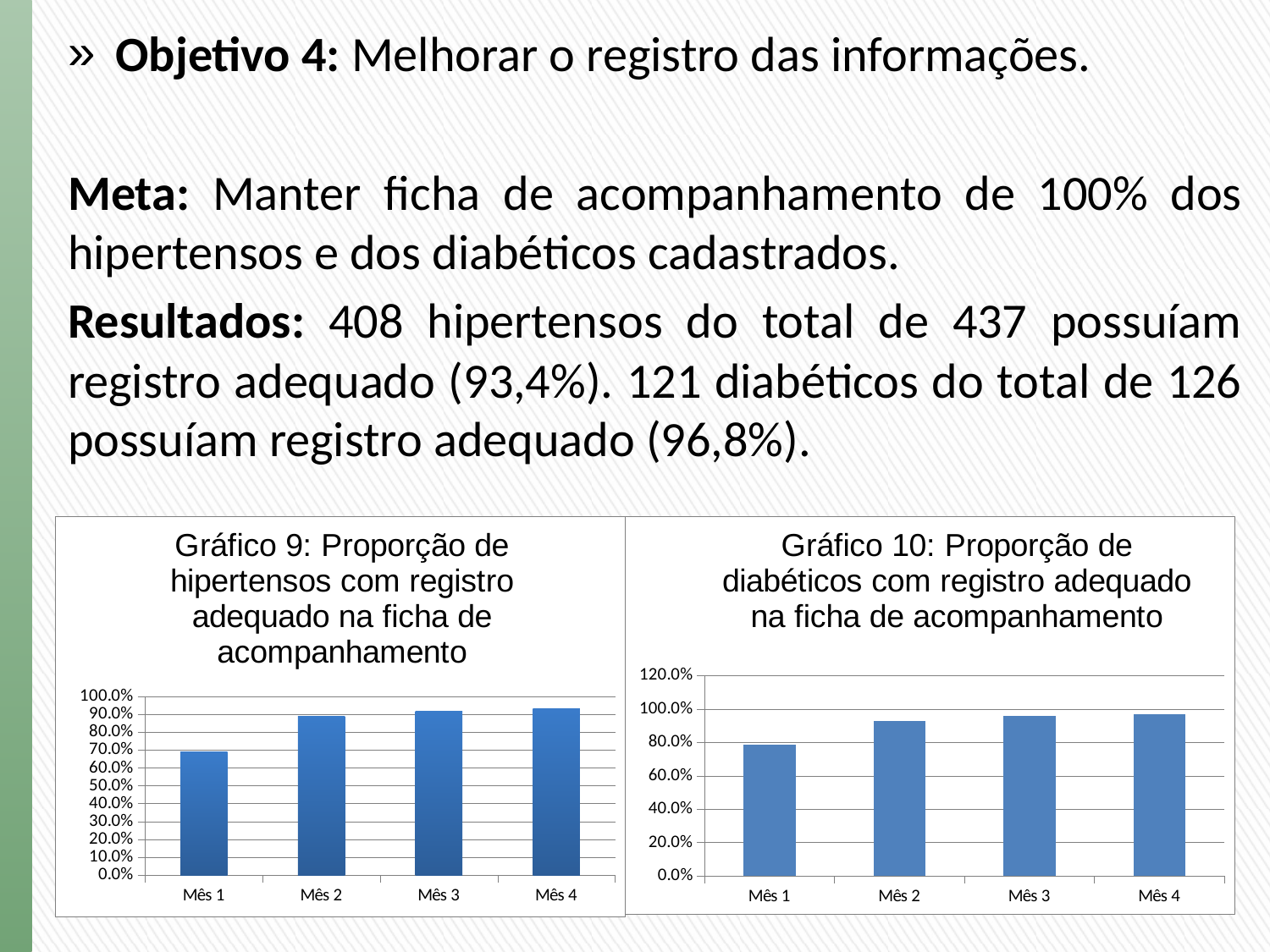
In Gráfico 9, which month has the lowest proportion? Mês 1 In Gráfico 9, is the value for Mês 2 greater or less than 80.0%? greater In Gráfico 9, is the value for Mês 1 greater or less than 60.0%? greater In Gráfico 10, do the values rise or fall from Mês 1 to Mês 4? rise What kind of chart is Gráfico 9? bar chart In Gráfico 9, which is larger, the value for Mês 1 or the value for Mês 2? Mês 2 In Gráfico 10, is the value for Mês 4 greater or less than 100.0%? less What is the title of the chart on the left of the slide? Gráfico 9: Proporção de hipertensos com registro adequado na ficha de acompanhamento How many categories are shown on the x axis of Gráfico 10? 4 In Gráfico 10, which is larger, the value for Mês 1 or the value for Mês 3? Mês 3 In Gráfico 10, which month has the lowest proportion? Mês 1